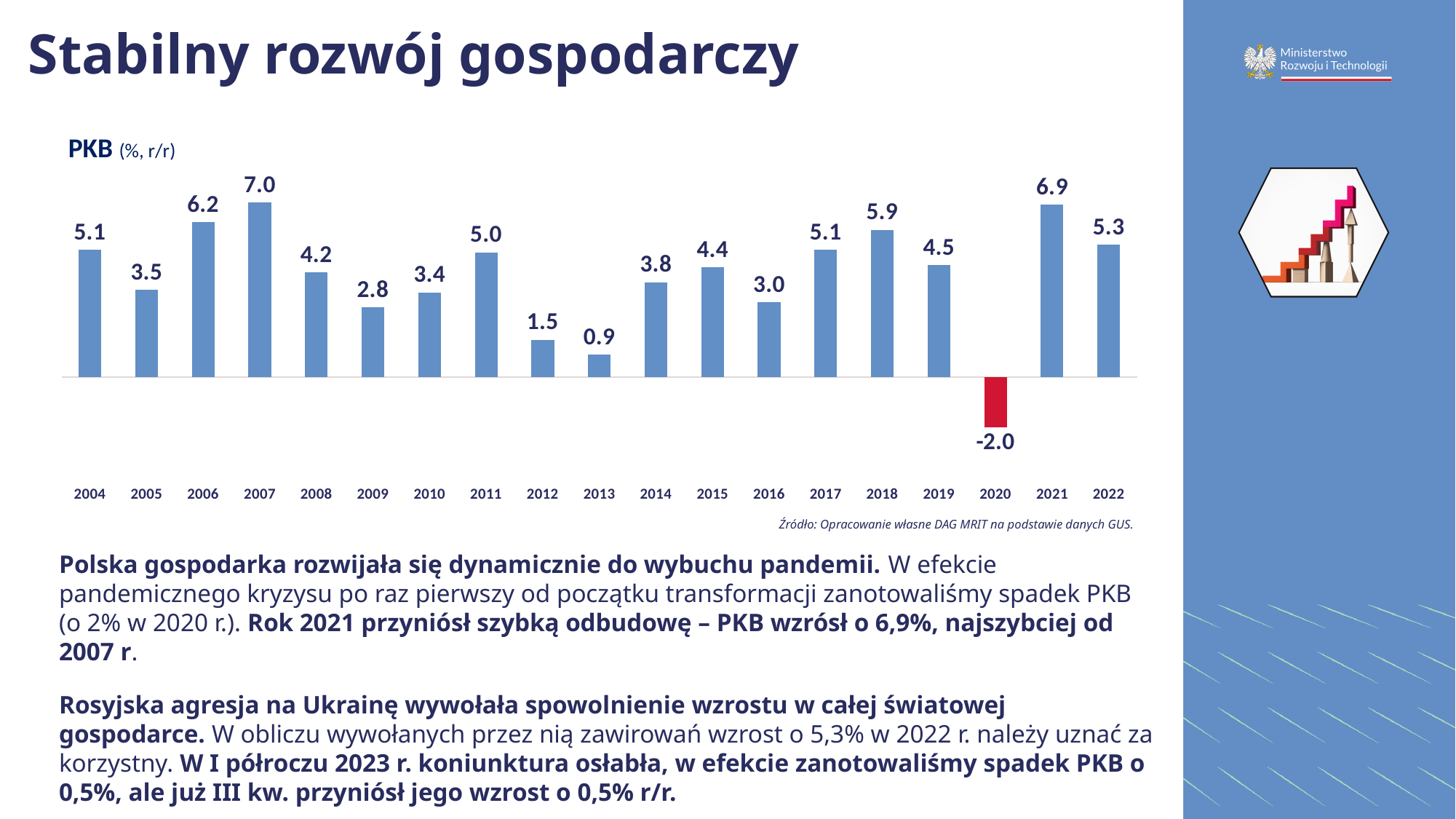
What is the PKB value for 2020? -2.0 What colour is the bar for 2020? Red What kind of chart is shown on the slide? Bar chart Do the PKB values rise or fall from 2011 to 2013? Fall How many years are shown on the chart? 19 What is the difference between the PKB values for 2007 and 2008? 2.8 Which year has the highest PKB value? 2007 What is the PKB value for 2007? 7.0 What is the difference between the PKB values for 2021 and 2022? 1.6 Which year has a larger PKB value, 2018 or 2019? 2018 What is the PKB value for 2013? 0.9 Which year has the lowest PKB value? 2020